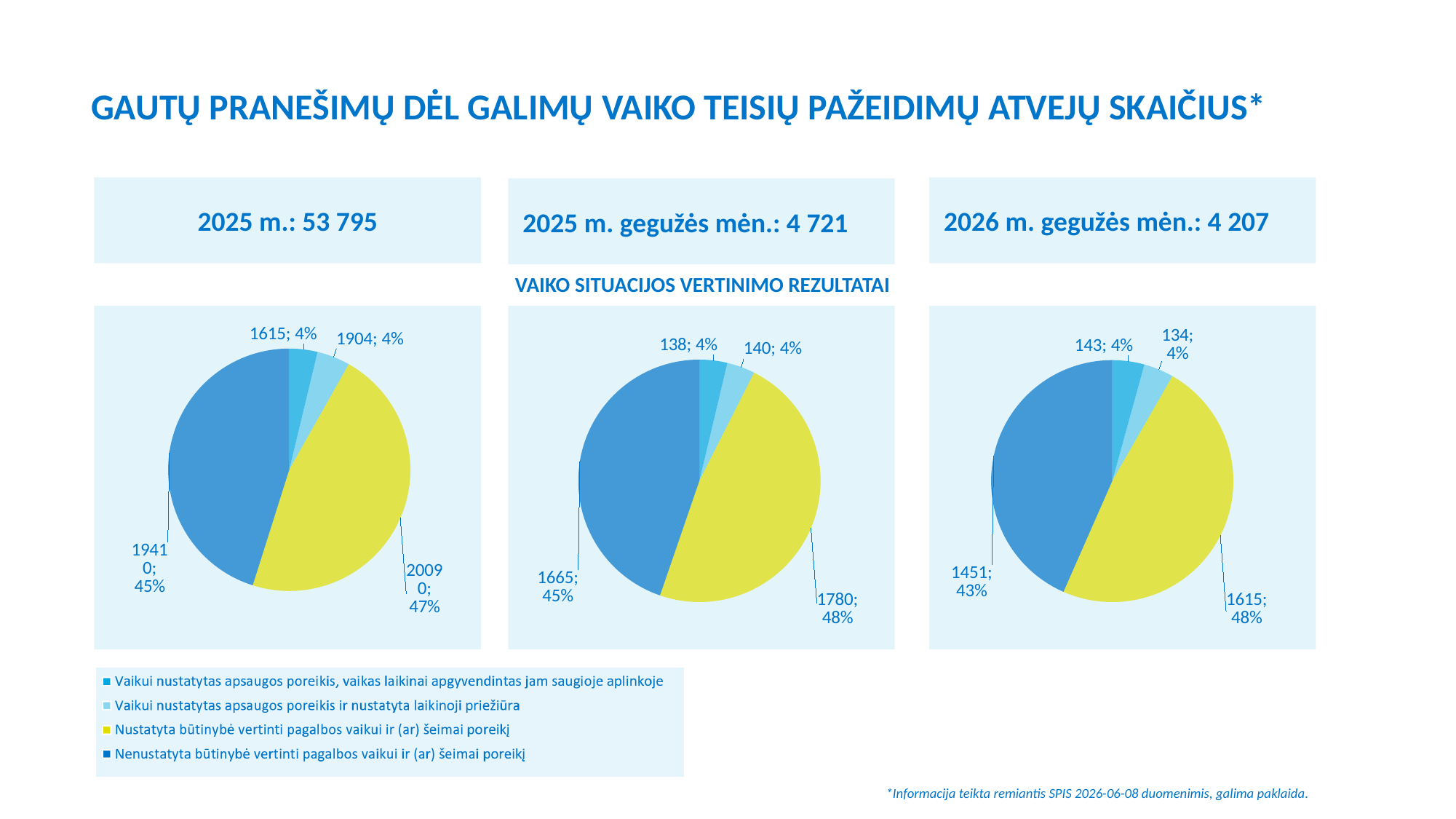
In the middle pie chart (2025 m. gegužės mėn.), what is the value of the yellow slice (Nustatyta būtinybė vertinti pagalbos vaikui ir (ar) šeimai poreikį)? 1780 In the left pie chart (2025 m.), what is the value of the slice with the 4% share that is shown in the lightest blue? 1904 How many categories does the legend list? 4 How many pie charts are on the slide? 3 What is the subtitle shown above the three pie charts? VAIKO SITUACIJOS VERTINIMO REZULTATAI In the left pie chart (2025 m.), what share does the yellow slice have? 47% In the right pie chart (2026 m. gegužės mėn.), which is larger: the slice labelled 143 or the slice labelled 134? 143 In the right pie chart (2026 m. gegužės mėn.), which slice is the largest? Nustatyta būtinybė vertinti pagalbos vaikui ir (ar) šeimai poreikį (1615; 48%) In the right pie chart (2026 m. gegužės mėn.), what share does the slice labelled 1451 have? 43% What kind of charts are shown on the slide? Pie charts What total number is shown in the header above the middle pie chart (2025 m. gegužės mėn.)? 4 721 In the middle pie chart (2025 m. gegužės mėn.), what is the difference between the slice labelled 1780 and the slice labelled 1665? 115